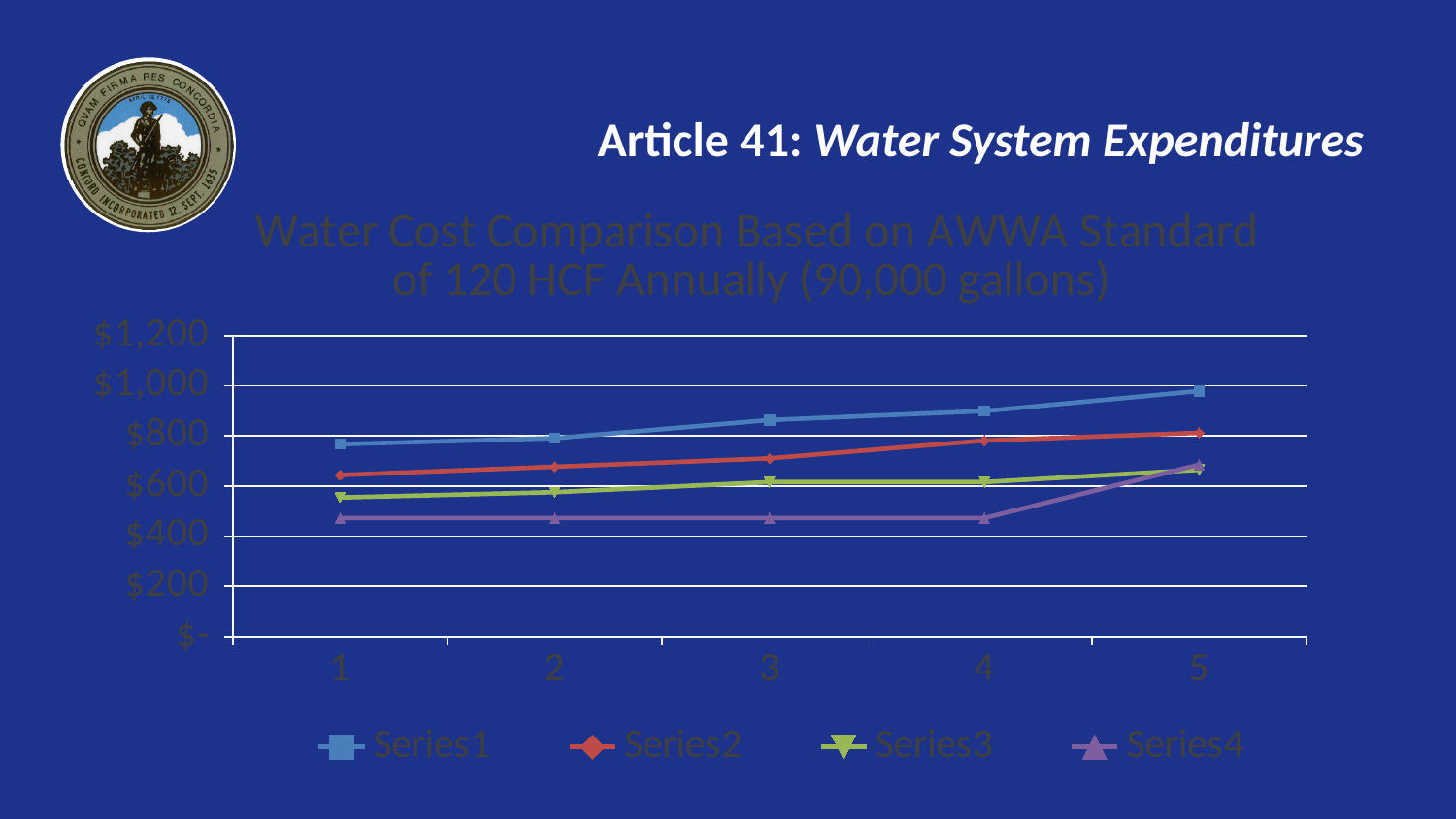
Which series has the lowest value at point 1? Series4 What kind of chart is shown on the slide? line chart Is the value for Series1 at point 5 greater or less than $800? greater How many series does the legend list? 4 Which is larger at point 3, Series1 or Series4? Series1 Is the value for Series4 at point 1 greater or less than $600? less Is the value for Series2 at point 3 greater or less than $600? greater Which series has the highest value at point 1? Series1 How many points are plotted along the x axis for each series? 5 What is the title of the chart? Water Cost Comparison Based on AWWA Standard of 120 HCF Annually (90,000 gallons) Do the values for Series1 rise or fall from point 1 to point 5? rise